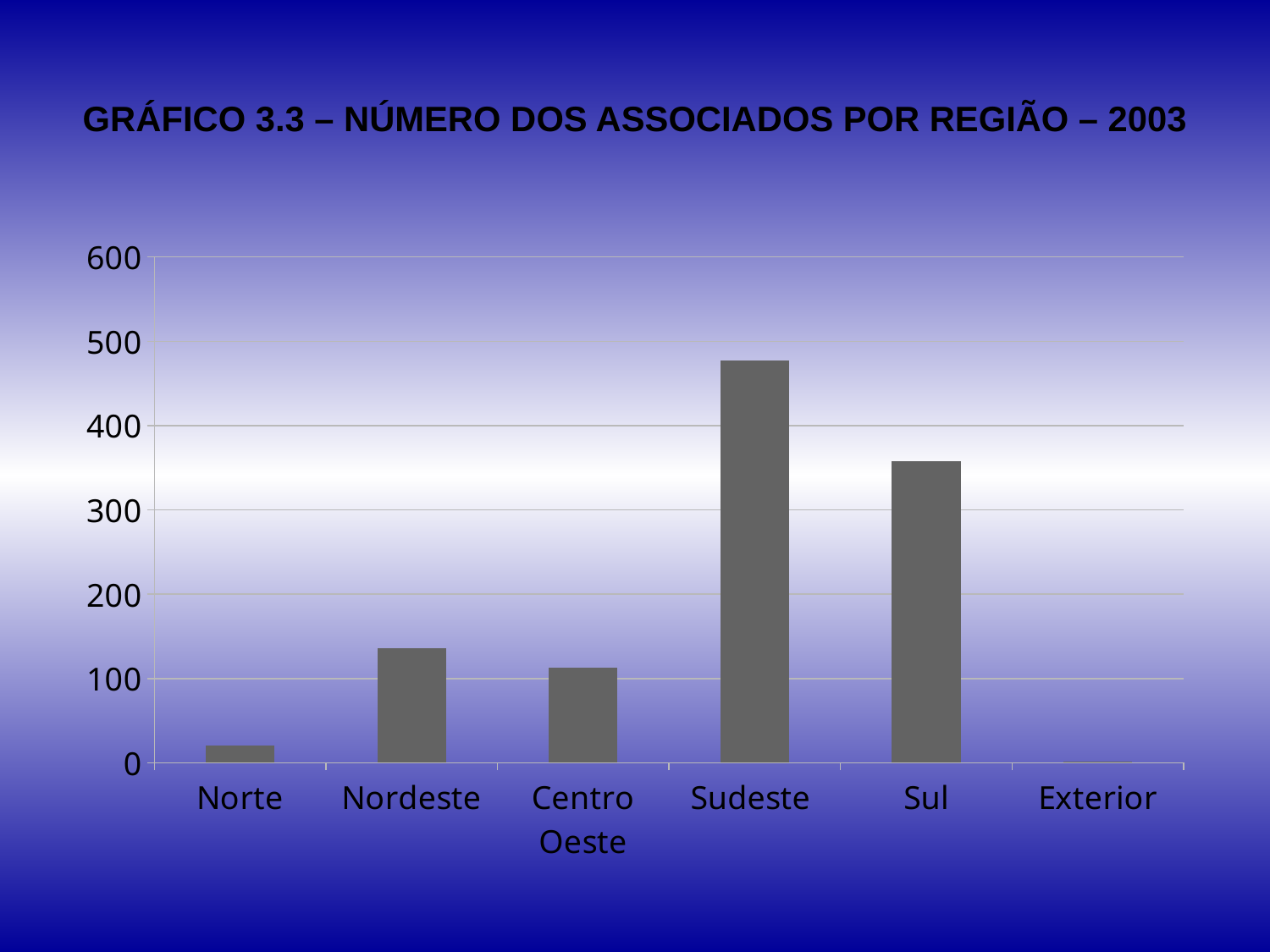
Which has a larger value, Sudeste or Sul? Sudeste Which has a larger value, Norte or Nordeste? Nordeste Is the value for Sul greater or less than 400? less Is the value for Norte greater or less than 100? less Is the value for Centro Oeste greater or less than 200? less What is the title of the chart on the slide? GRÁFICO 3.3 – NÚMERO DOS ASSOCIADOS POR REGIÃO – 2003 Which region has the highest number of associates in the chart? Sudeste What kind of chart is shown on the slide? bar chart How many regions are shown on the x axis of the chart? 6